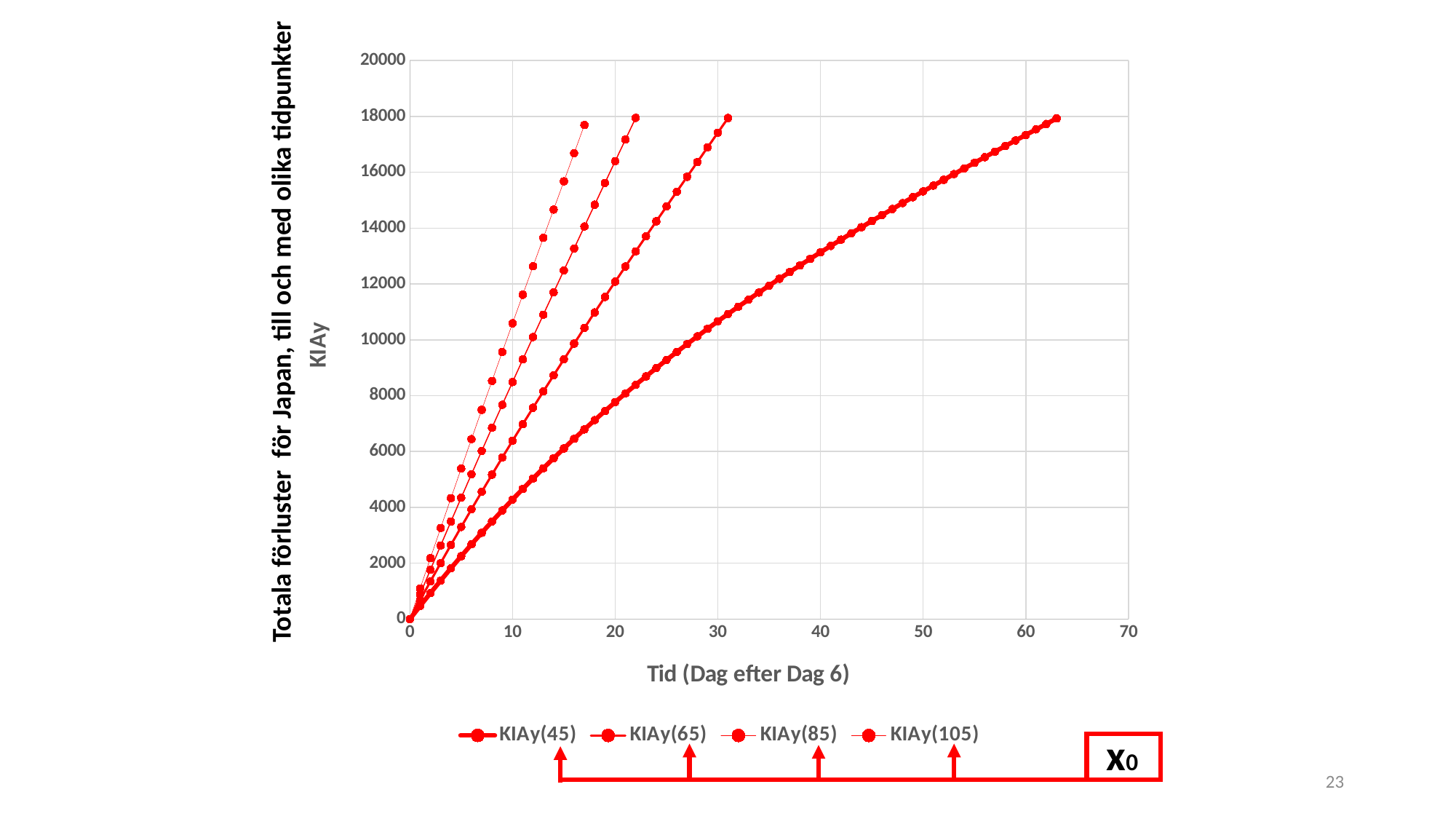
What is the highest tick value shown on the y axis? 20000 What kind of chart is shown on the slide? Line chart Is the value of the KIAy(45) series at day 40 greater or less than 10000? greater How many series does the legend list? 4 Which series rises most steeply, reaching about 18000 in the fewest days? KIAy(105) Is the value of the KIAy(65) series at day 10 greater or less than 8000? less Is the value of the KIAy(105) series at day 10 greater or less than 8000? greater Do the values of the KIAy(45) series rise or fall as time increases along the x axis? Rise At day 20, which series has the larger value, KIAy(45) or KIAy(85)? KIAy(85) Which series extends furthest along the x axis (to the highest day value)? KIAy(45) What is the title of the x axis? Tid (Dag efter Dag 6)